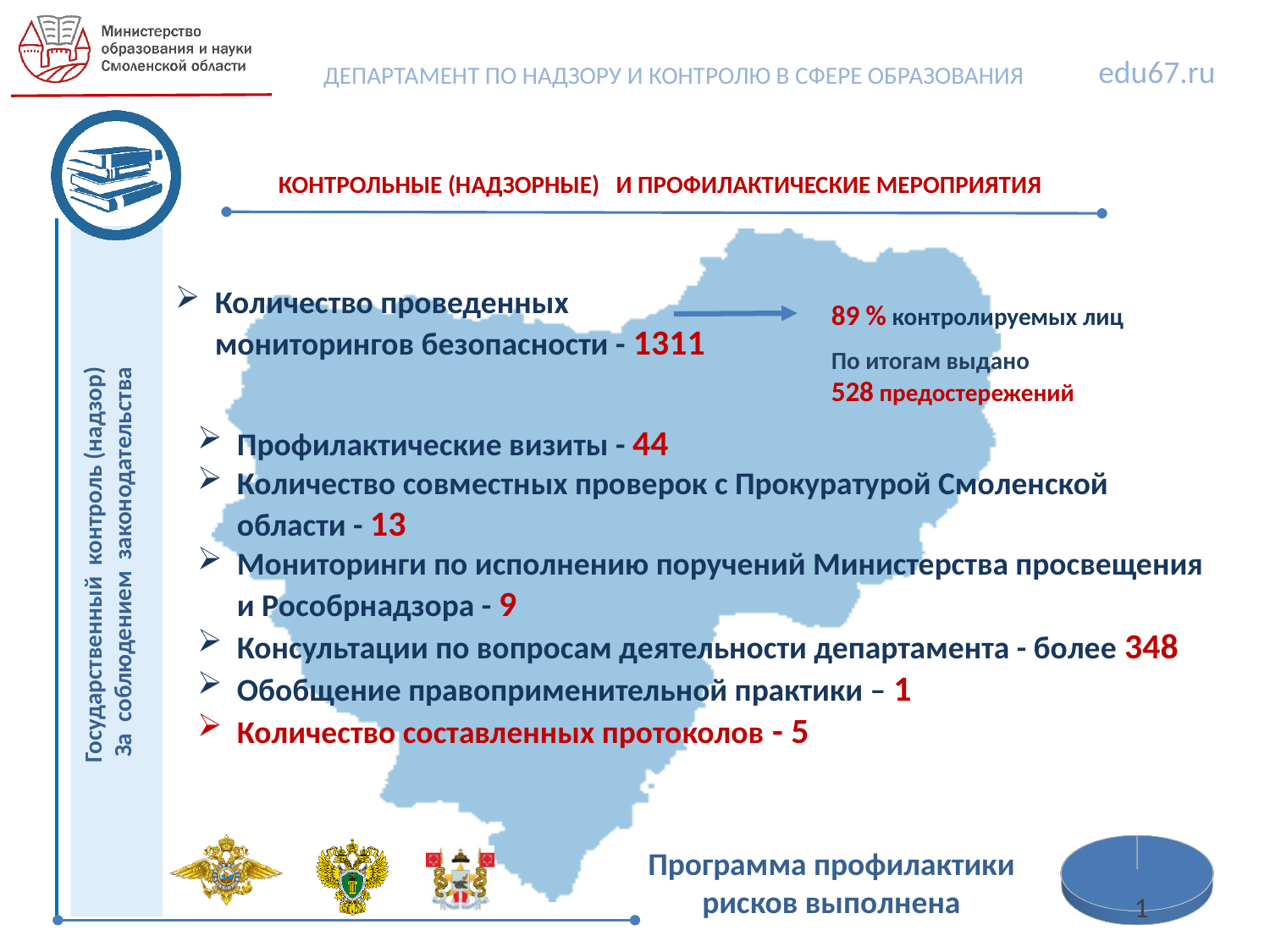
What data label is printed on the pie chart in the bottom right corner of the slide? 1 How many slices does the pie chart in the bottom right corner of the slide have? 1 What share of the pie chart in the bottom right corner of the slide does its single slice take up? 100% What kind of chart is shown in the bottom right corner of the slide? pie chart Does the pie chart in the bottom right corner of the slide have a legend? No What colour is the slice of the pie chart in the bottom right corner of the slide? blue